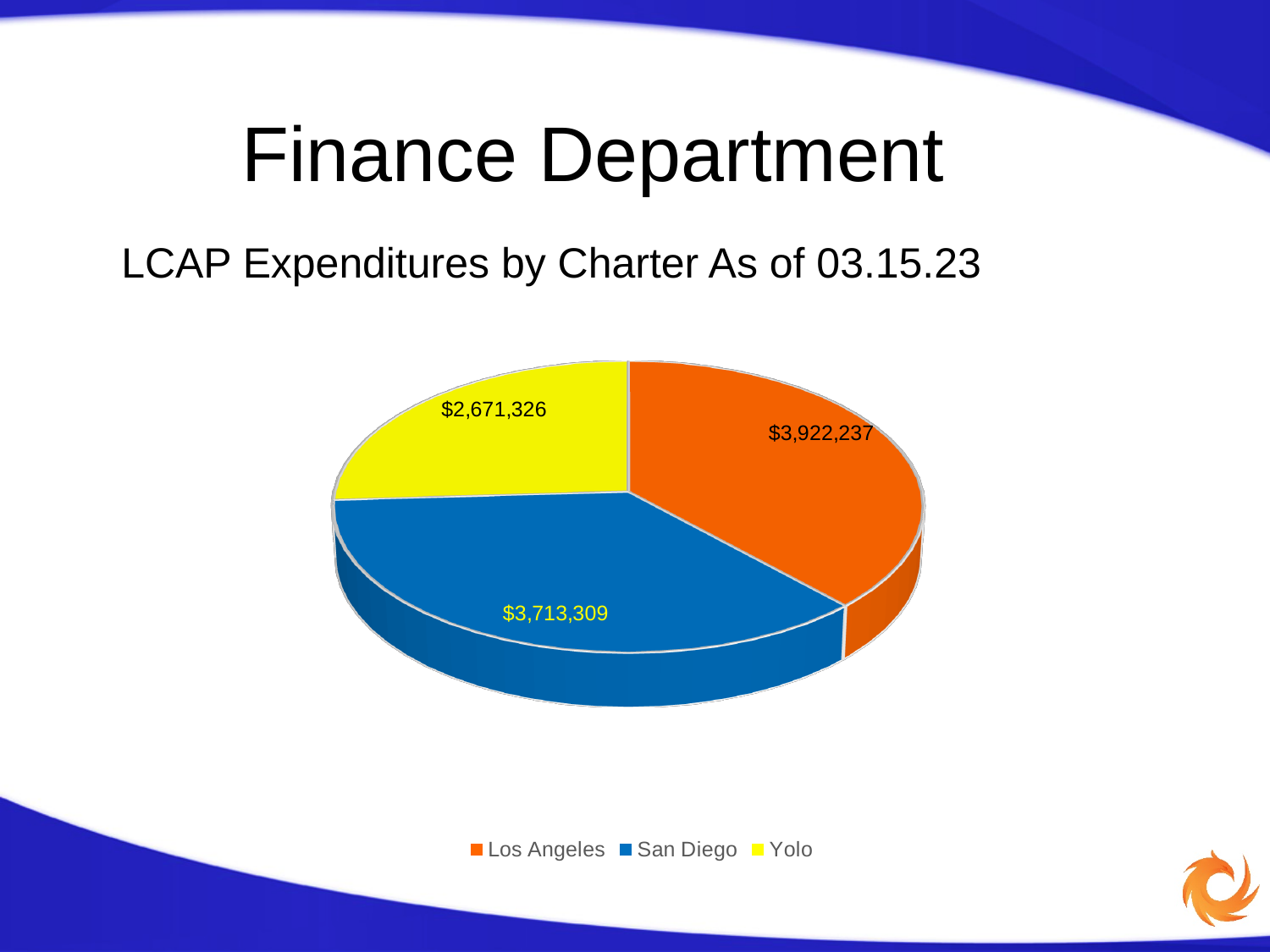
What is the LCAP expenditure value shown for San Diego? $3,713,309 How many charters (slices) are shown in the pie chart? 3 What is the total of the three expenditure values shown in the pie chart? $10,306,872 What type of chart is used on this slide? Pie chart What is the difference between the Los Angeles and San Diego expenditure values? $208,928 Which charter has the highest LCAP expenditure in the pie chart? Los Angeles Which is larger, the expenditure for Los Angeles or for San Diego? Los Angeles Which colour represents San Diego in the pie chart? Blue Which charter has the lowest LCAP expenditure in the pie chart? Yolo What is the LCAP expenditure value shown for Yolo? $2,671,326 What is the LCAP expenditure value shown for Los Angeles? $3,922,237 What is the difference between the San Diego and Yolo expenditure values? $1,041,983